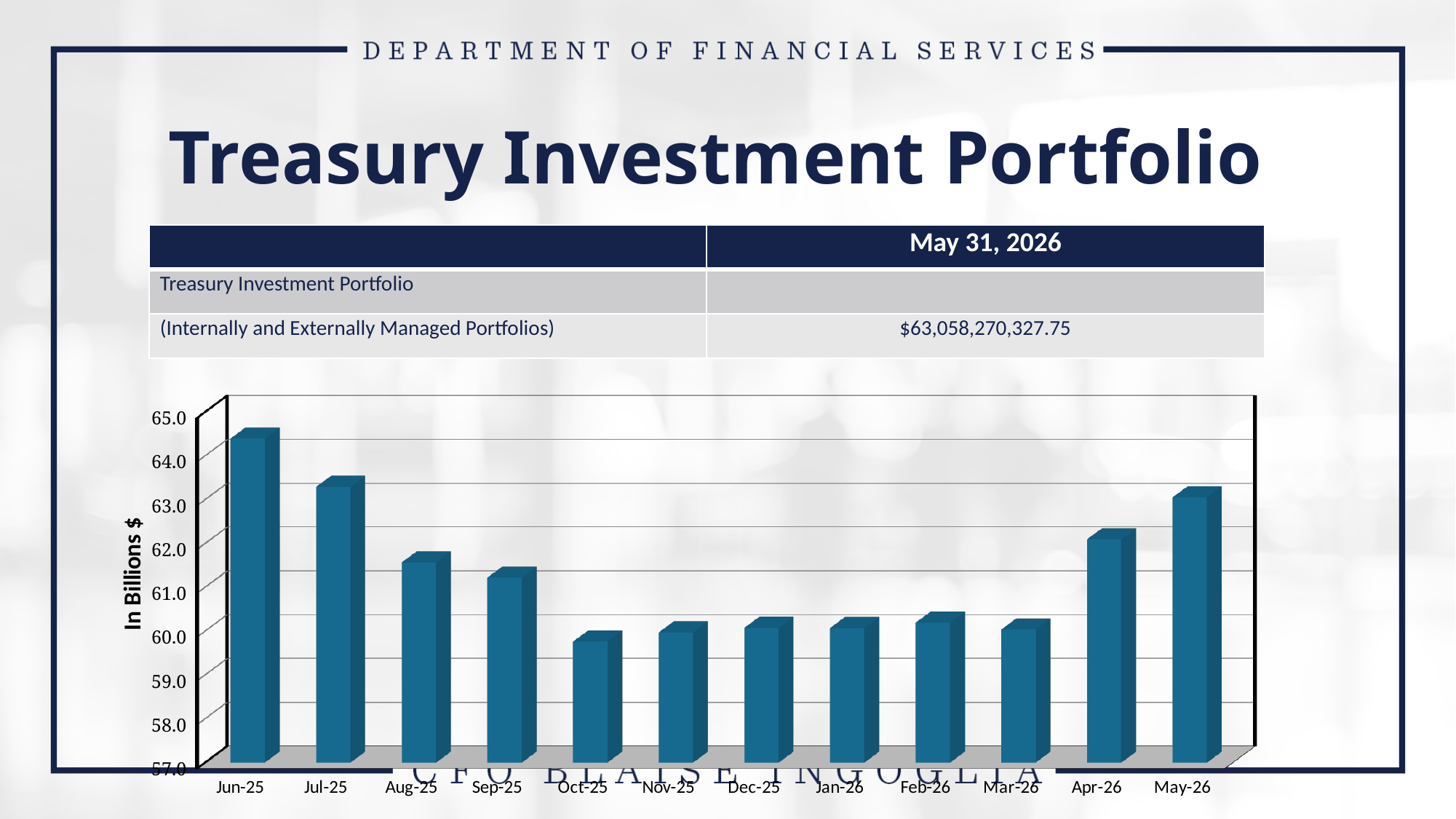
Do the values rise or fall from Jun-25 to Oct-25? fall Which is larger, the value for Jul-25 or the value for Apr-26? Jul-25 Is the value for May-26 greater or less than 62.0? greater Is the value for Oct-25 greater or less than 61.0? less Which month has the highest value on the chart? Jun-25 Is the value for Jul-25 greater or less than 62.0? greater Which month has the lowest value on the chart? Oct-25 How many months are plotted on the chart? 12 What is the label on the vertical axis of the chart? In Billions $ What kind of chart is shown on the slide? bar chart Which is larger, the value for Jun-25 or the value for May-26? Jun-25